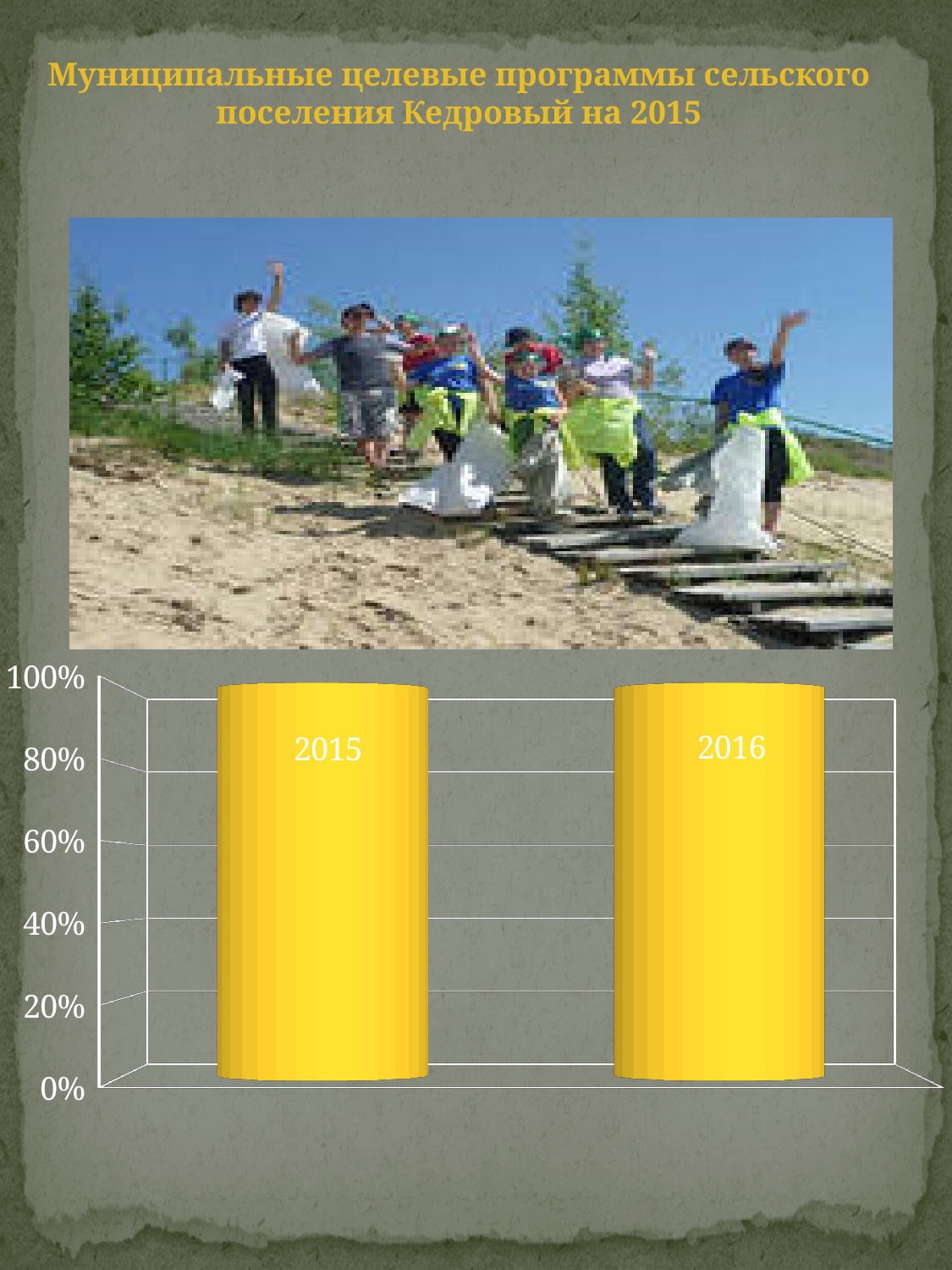
Is the value for 2015 greater or less than 80%? greater How many bars are plotted in the chart? 2 Is the value for 2016 greater or less than 60%? greater What is the highest tick shown on the vertical axis of the chart? 100% Which two years are labelled on the bars of the chart? 2015 and 2016 Is the value for 2015 greater or less than 40%? greater Do the values rise, fall or stay the same from 2015 to 2016? stay the same What kind of chart is shown on the slide? bar chart